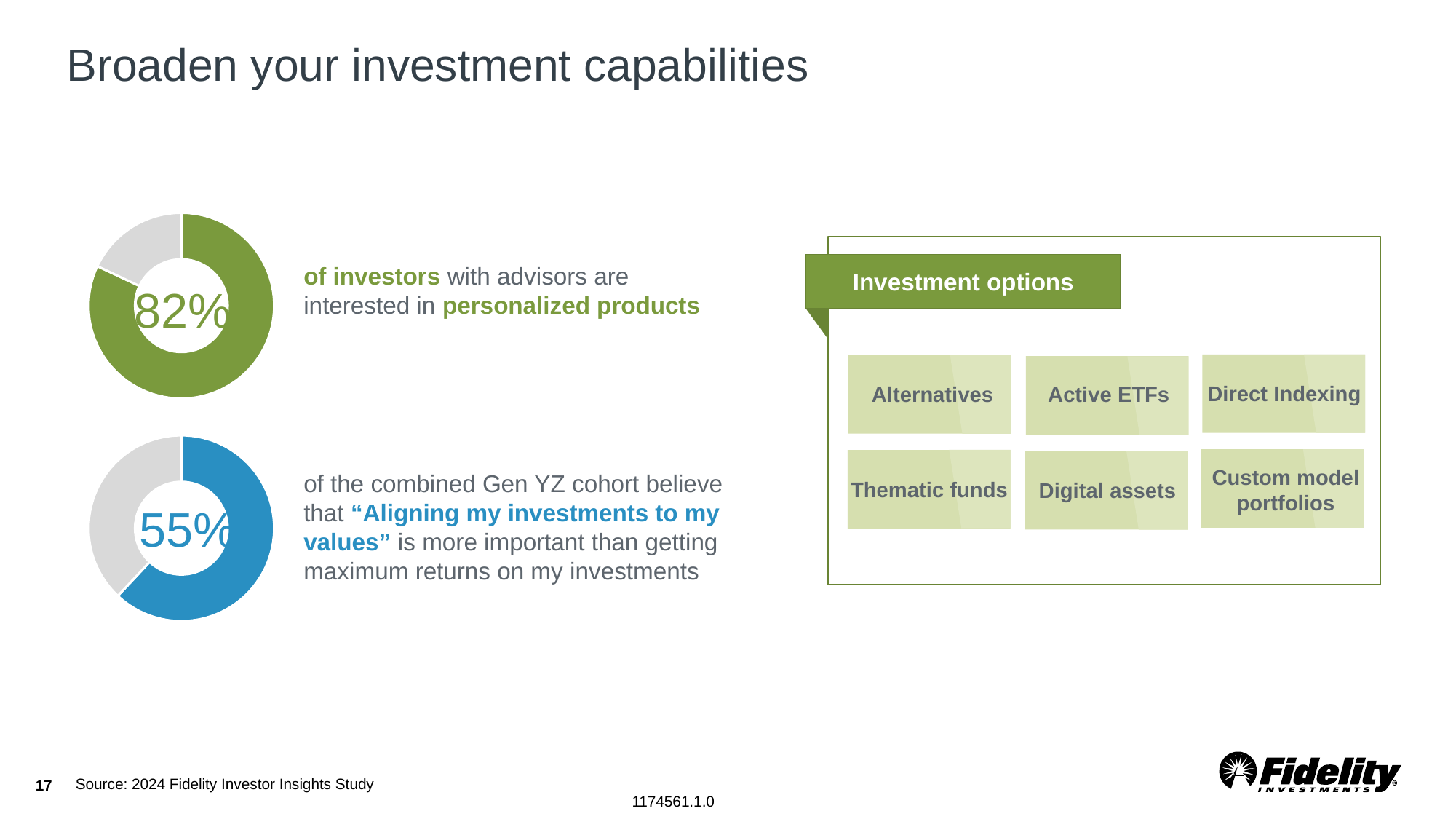
In the top donut chart, what share of the ring is left grey (unshaded)? 18% What value is shown in the centre of the bottom (blue) donut chart? 55% What colour is the filled portion of the bottom donut chart? Blue According to the text next to the top donut chart, what does the 82% represent? Investors with advisors interested in personalized products What kind of chart is used to show the 82% and 55% figures? Donut (pie) chart What value is shown in the centre of the top (green) donut chart? 82% Which donut chart shows the larger percentage, the top one or the bottom one? The top one (82%) What is the difference between the percentage in the top donut chart and the percentage in the bottom donut chart? 27 percentage points How many donut charts are shown on the slide? 2 In the top donut chart, what share of the ring is shaded green? 82%